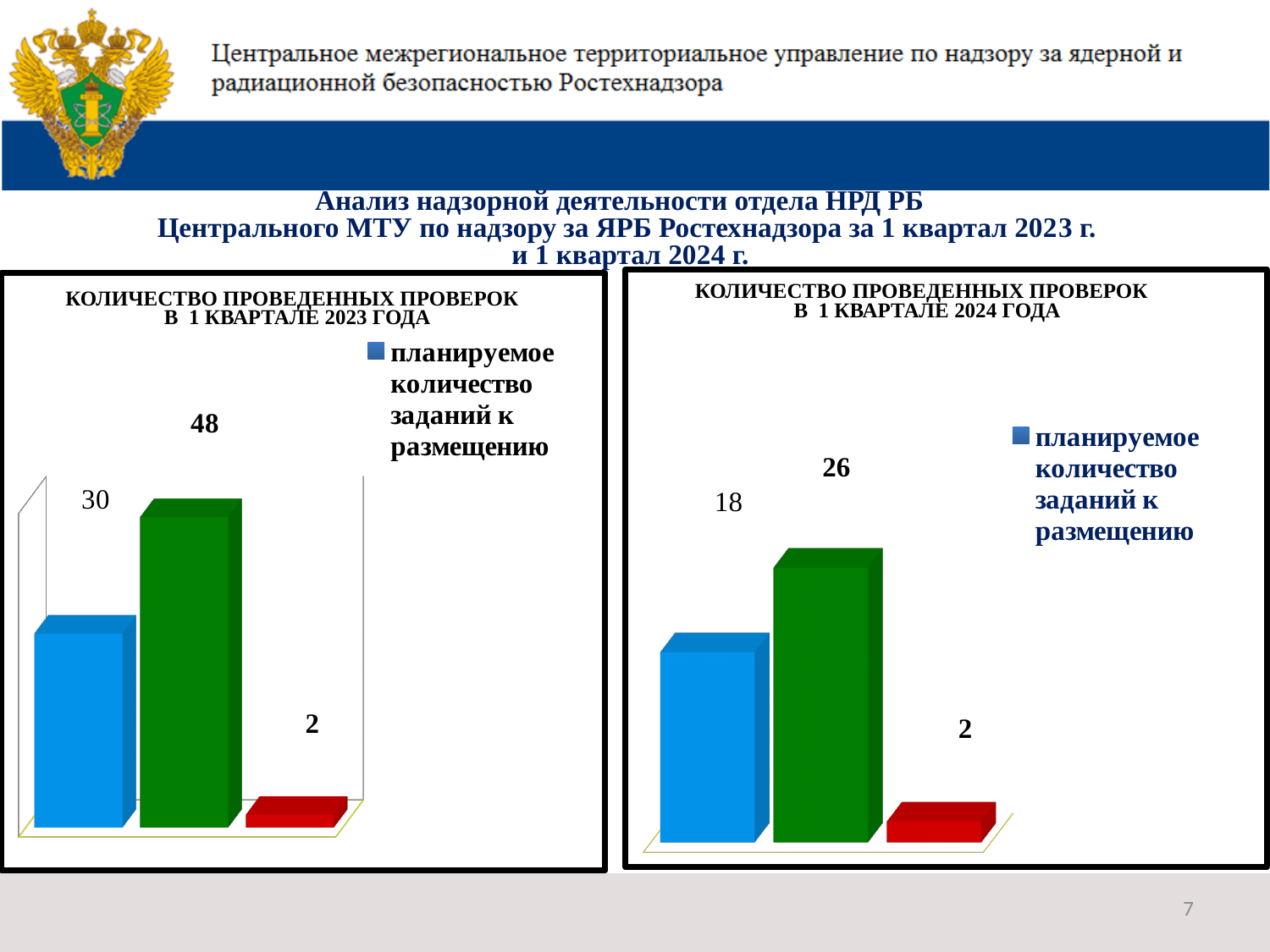
In the left chart (1 квартал 2023 года), what is the value of the bar for 'планируемое количество заданий к размещению'? 30 What is the title of the chart on the right side of the slide? КОЛИЧЕСТВО ПРОВЕДЕННЫХ ПРОВЕРОК В 1 КВАРТАЛЕ 2024 ГОДА How many entries does the legend of the right chart (1 квартал 2024 года) list? 1 How many bars are plotted in the left chart (1 квартал 2023 года)? 3 In the left chart (1 квартал 2023 года), what is the lowest value shown on any bar? 2 In the right chart (1 квартал 2024 года), what is the highest value shown on any bar? 26 In the right chart (1 квартал 2024 года), what is the value of the bar for 'планируемое количество заданий к размещению'? 18 What kind of chart is shown on the left side of the slide, titled 'КОЛИЧЕСТВО ПРОВЕДЕННЫХ ПРОВЕРОК В 1 КВАРТАЛЕ 2023 ГОДА'? bar chart Comparing the two charts, is the value for 'планируемое количество заданий к размещению' larger in the 2023 chart or in the 2024 chart? 2023 chart In the left chart (1 квартал 2023 года), what is the difference between the highest bar value and the lowest bar value? 46 In the left chart (1 квартал 2023 года), what is the highest value shown on any bar? 48 In the right chart (1 квартал 2024 года), what is the lowest value shown on any bar? 2